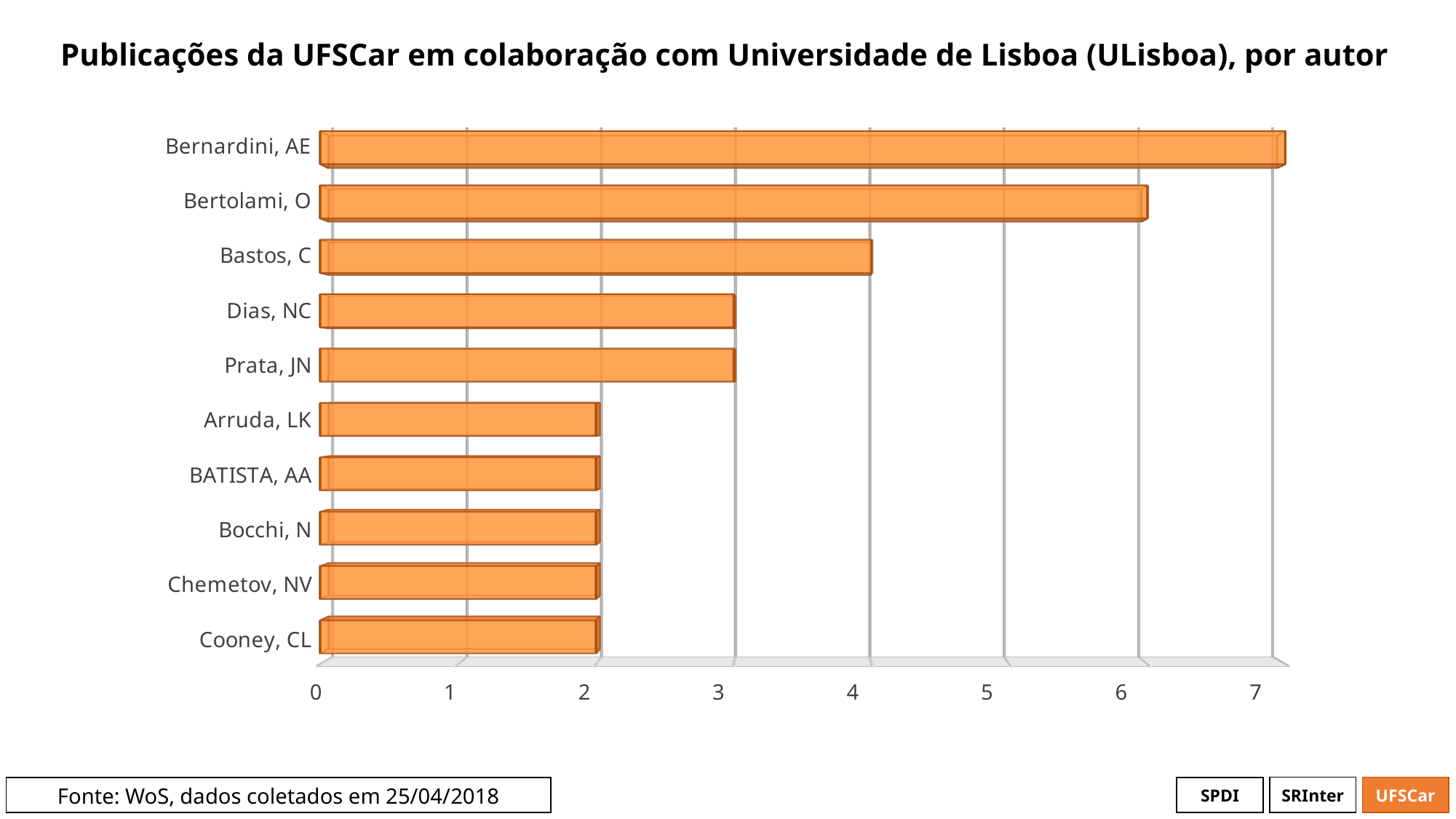
How many publications does Bernardini, AE have? 7 How many publications does Bastos, C have? 4 How many authors are listed on the chart? 10 How many publications does Bertolami, O have? 6 Who has more publications, Bastos, C or Dias, NC? Bastos, C Is the value for Cooney, CL greater or less than 3? less What is the difference between the publications of Bernardini, AE and Bastos, C? 3 Is the value for Bernardini, AE greater or less than 5? greater How many authors have exactly 2 publications? 5 Which author has the highest number of publications? Bernardini, AE What kind of chart is shown on the slide? bar chart What is the title of the chart? Publicações da UFSCar em colaboração com Universidade de Lisboa (ULisboa), por autor